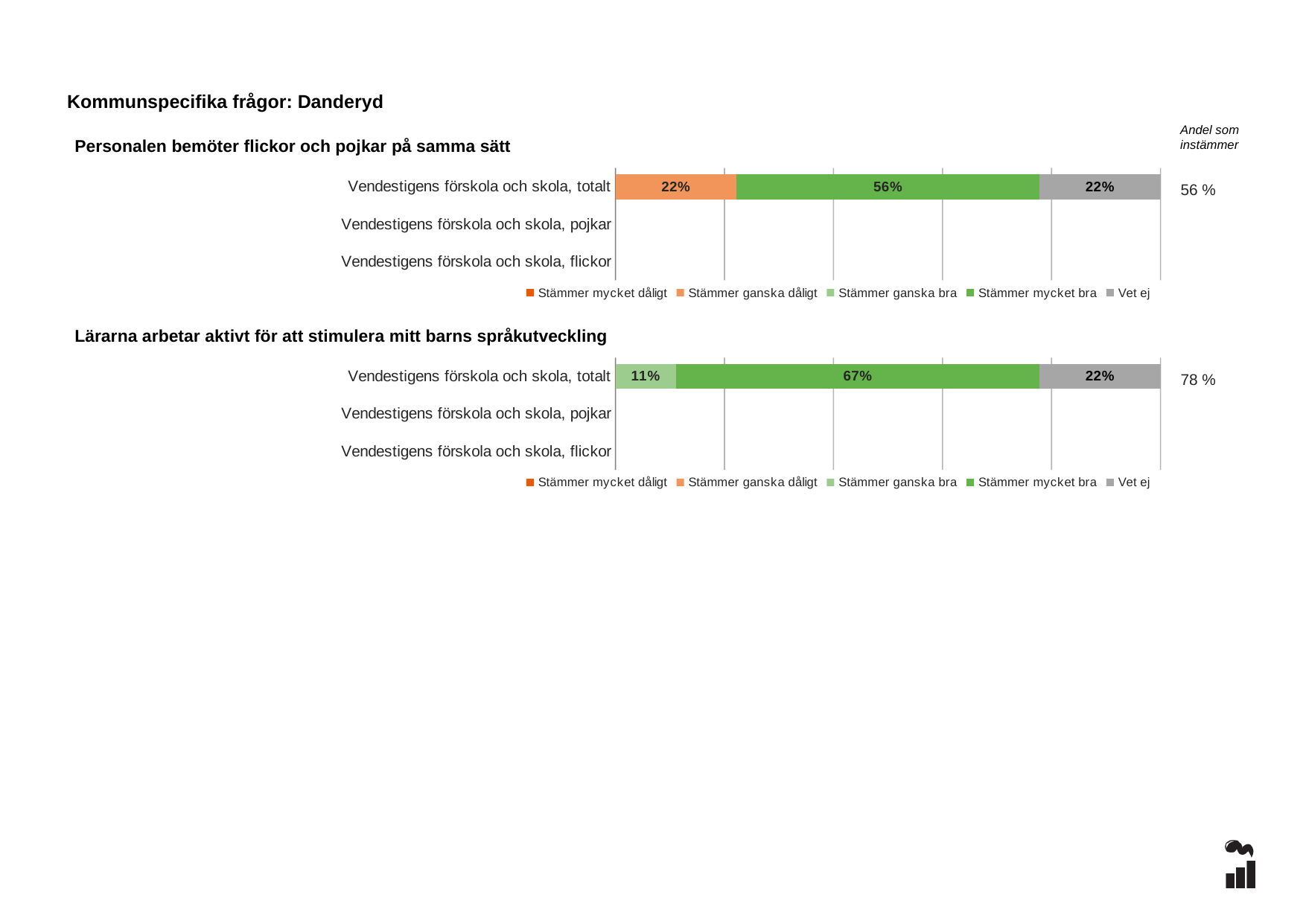
In the chart 'Lärarna arbetar aktivt för att stimulera mitt barns språkutveckling', what is the 'Andel som instämmer' value shown for 'Vendestigens förskola och skola, totalt'? 78 % In the chart 'Personalen bemöter flickor och pojkar på samma sätt', what percentage of 'Vendestigens förskola och skola, totalt' answered 'Stämmer mycket bra'? 56% In the chart 'Lärarna arbetar aktivt för att stimulera mitt barns språkutveckling', what is the difference between the 'Stämmer mycket bra' and 'Vet ej' shares for 'Vendestigens förskola och skola, totalt'? 45% In the chart 'Personalen bemöter flickor och pojkar på samma sätt', what is the 'Andel som instämmer' value shown for 'Vendestigens förskola och skola, totalt'? 56 % In the chart 'Personalen bemöter flickor och pojkar på samma sätt', what percentage of 'Vendestigens förskola och skola, totalt' answered 'Vet ej'? 22% How many categories are shown on the y axis of the chart 'Personalen bemöter flickor och pojkar på samma sätt'? 3 In the chart 'Personalen bemöter flickor och pojkar på samma sätt', what percentage of 'Vendestigens förskola och skola, totalt' answered 'Stämmer ganska dåligt'? 22% In the chart 'Lärarna arbetar aktivt för att stimulera mitt barns språkutveckling', what percentage of 'Vendestigens förskola och skola, totalt' answered 'Stämmer ganska bra'? 11% In the chart 'Personalen bemöter flickor och pojkar på samma sätt', which is larger for 'Vendestigens förskola och skola, totalt': the 'Stämmer mycket bra' share or the 'Vet ej' share? Stämmer mycket bra What kind of chart is 'Lärarna arbetar aktivt för att stimulera mitt barns språkutveckling'? Stacked bar chart In the chart 'Lärarna arbetar aktivt för att stimulera mitt barns språkutveckling', what percentage of 'Vendestigens förskola och skola, totalt' answered 'Stämmer mycket bra'? 67% How many series does the legend of the chart 'Lärarna arbetar aktivt för att stimulera mitt barns språkutveckling' list? 5